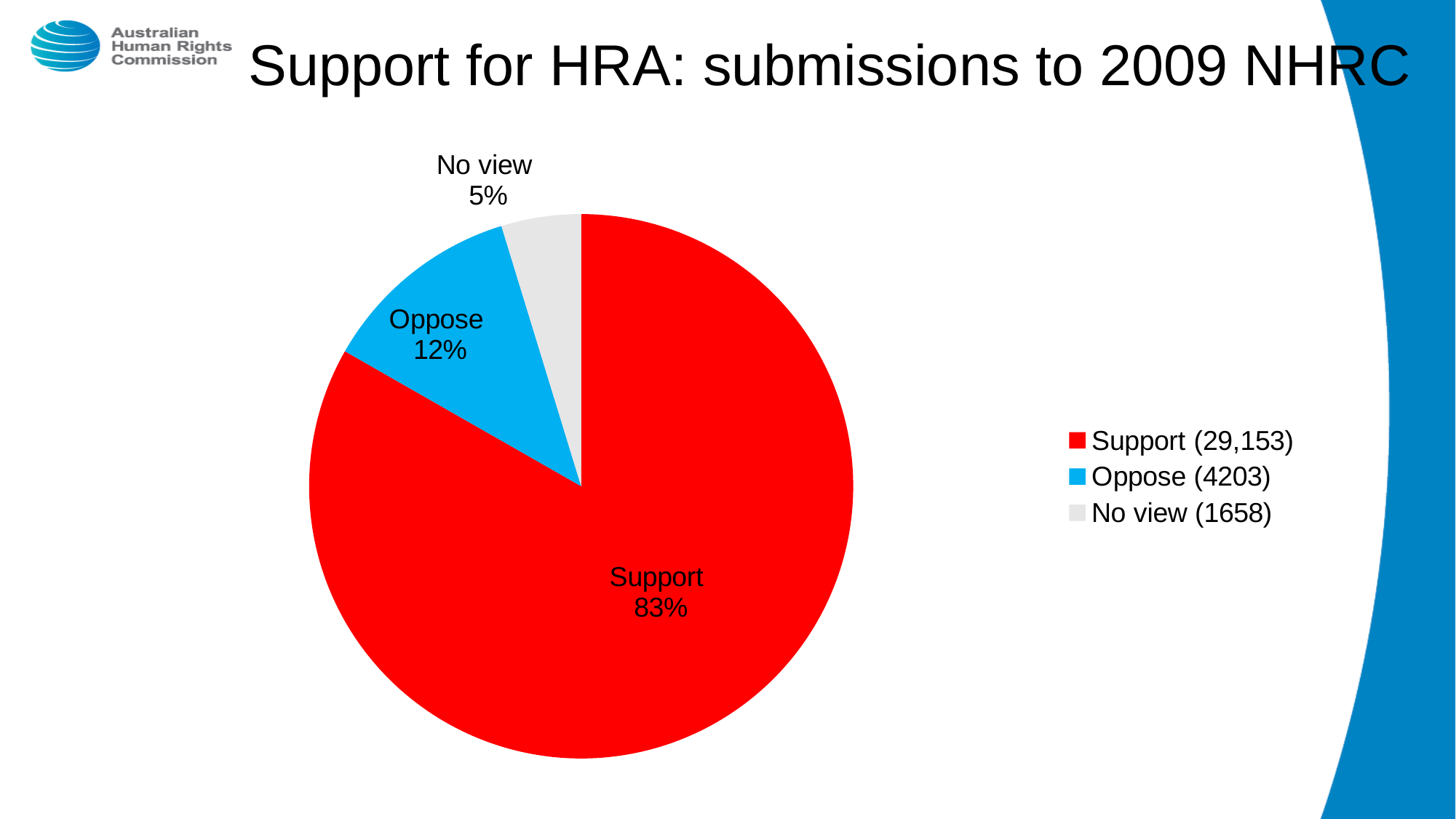
What share of the pie does the No view slice represent? 5% Which category has the smallest slice of the pie? No view How many slices does the pie chart have? 3 According to the legend, how many submissions are in the Support category? 29,153 How many entries does the legend list? 3 What colour is the Oppose slice? blue Which is larger, the Oppose slice or the No view slice? Oppose What is the difference in percentage points between the Support share and the Oppose share? 71 What share of the pie does the Oppose slice represent? 12% What kind of chart is shown on the slide? pie chart Which category has the largest slice of the pie? Support What share of the pie does the Support slice represent? 83%